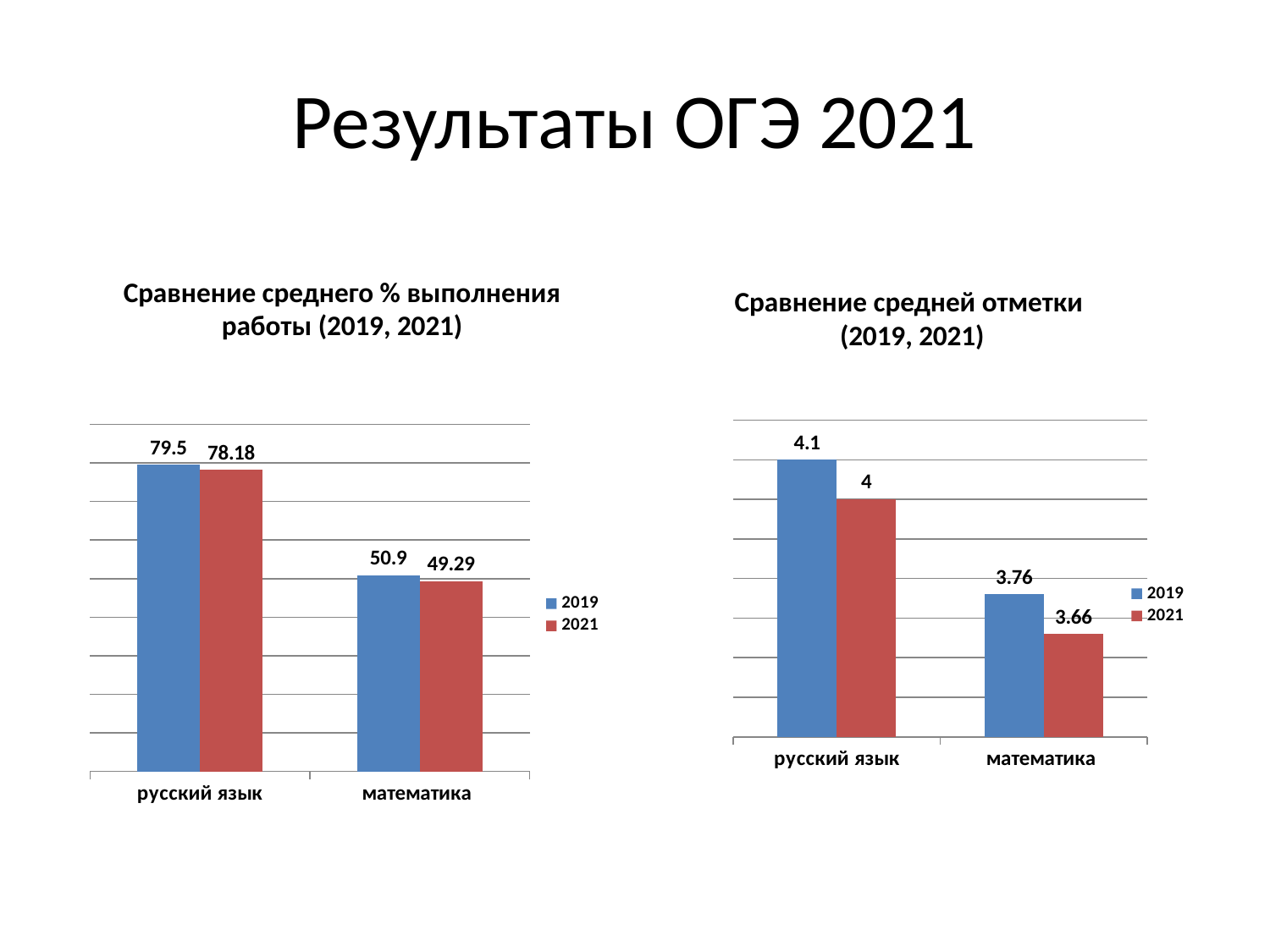
In the right chart (Сравнение средней отметки), what is the value for математика in 2019? 3.76 In the left chart (Сравнение среднего % выполнения работы), what is the value for русский язык in 2019? 79.5 In the left chart (Сравнение среднего % выполнения работы), what is the difference between the 2019 and 2021 values for математика? 1.61 In the left chart (Сравнение среднего % выполнения работы), which category has the highest value in 2019? русский язык In the left chart (Сравнение среднего % выполнения работы), which colour represents the 2021 series? red In the right chart (Сравнение средней отметки), what is the value for русский язык in 2021? 4 In the right chart (Сравнение средней отметки), which is larger for математика: the 2019 value or the 2021 value? 2019 What kind of chart is the right chart (Сравнение средней отметки)? bar chart In the right chart (Сравнение средней отметки), what is the difference between the 2019 and 2021 values for русский язык? 0.1 In the right chart (Сравнение средней отметки), which category has the lowest value in 2021? математика How many series does the legend of the left chart (Сравнение среднего % выполнения работы) list? 2 In the left chart (Сравнение среднего % выполнения работы), what is the value for математика in 2021? 49.29